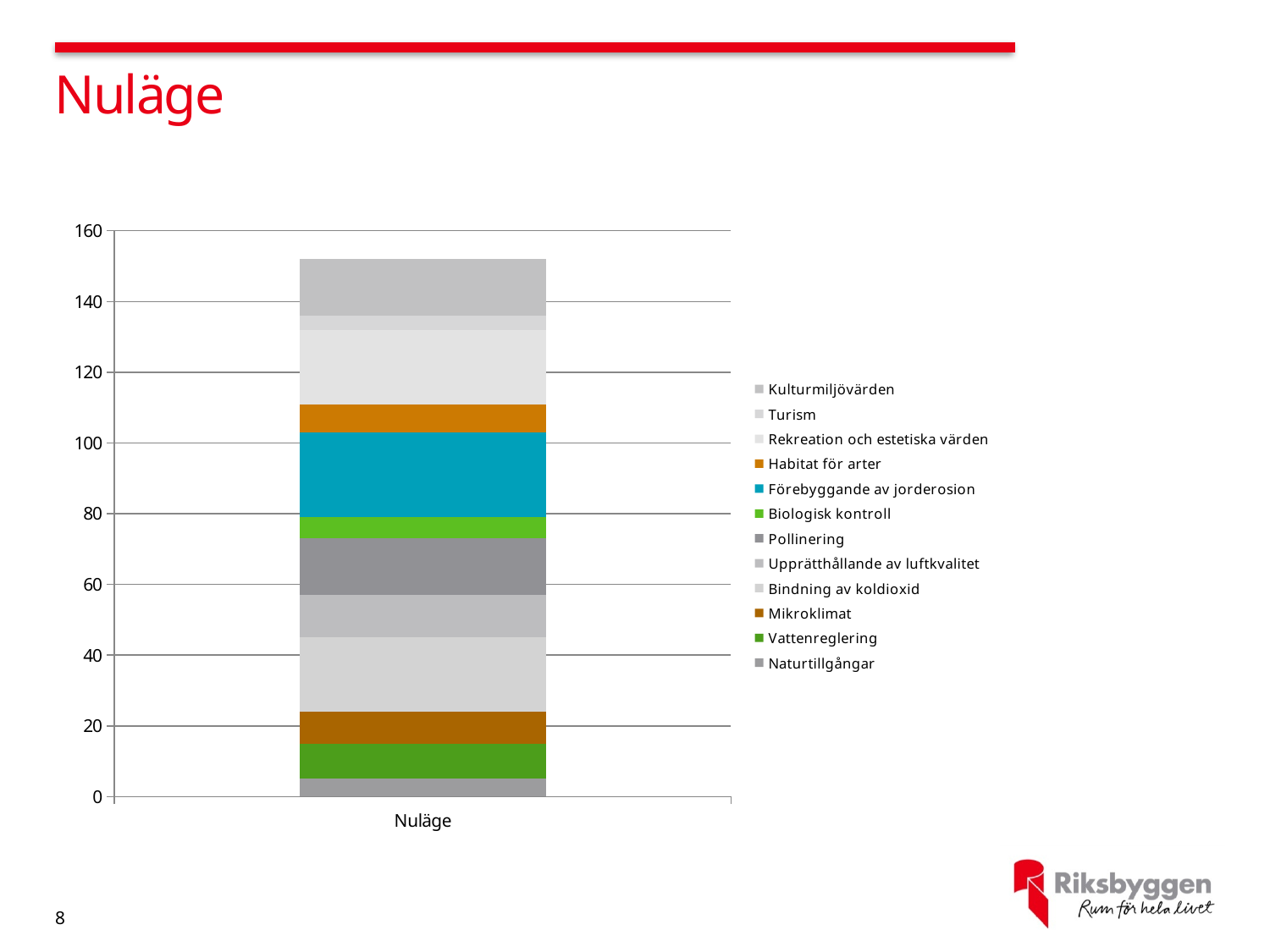
How many series does the chart's legend list? 12 Is the total height of the Nuläge stacked bar greater or less than 140? greater What kind of chart is shown on the slide? Stacked bar chart Is the total height of the Nuläge stacked bar greater or less than 160? less How many categories are plotted on the x axis of the chart? 1 What is the label of the single category on the x axis? Nuläge Which series forms the top segment of the stacked bar? Kulturmiljövärden Which series forms the bottom segment of the stacked bar? Naturtillgångar